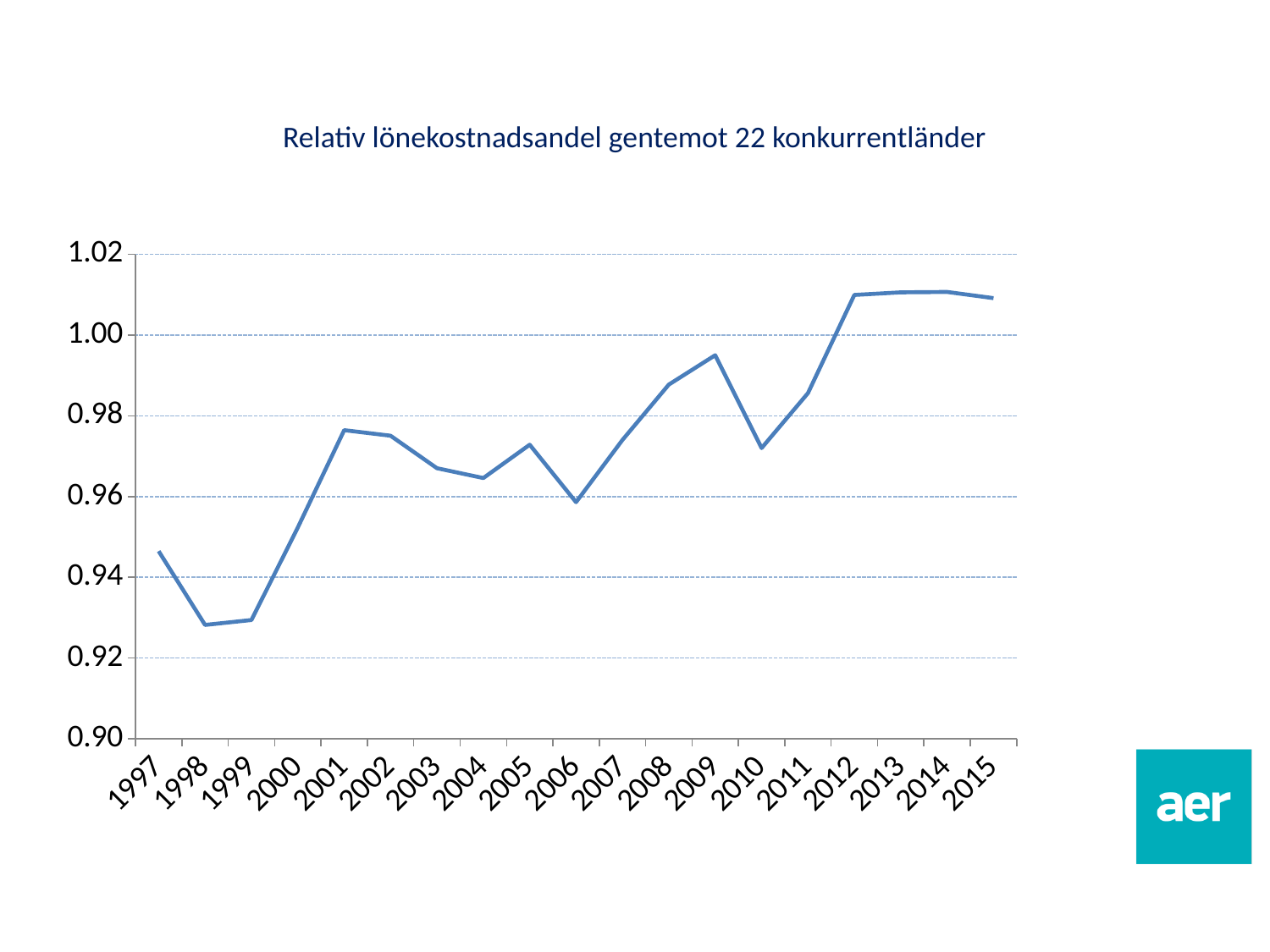
Which year has the larger value, 2010 or 2012? 2012 Is the value for 1998 greater or less than 0.94? less What is the title of the chart? Relativ lönekostnadsandel gentemot 22 konkurrentländer Is the value for 2012 greater or less than 1.00? greater Overall, do the values rise or fall from 1997 to 2015? rise What kind of chart is shown on the slide? line chart How many years are plotted on the x axis? 19 Which year has the larger value, 2006 or 2009? 2009 Is the value for 2010 greater or less than 0.98? less Which year has the larger value, 1999 or 2001? 2001